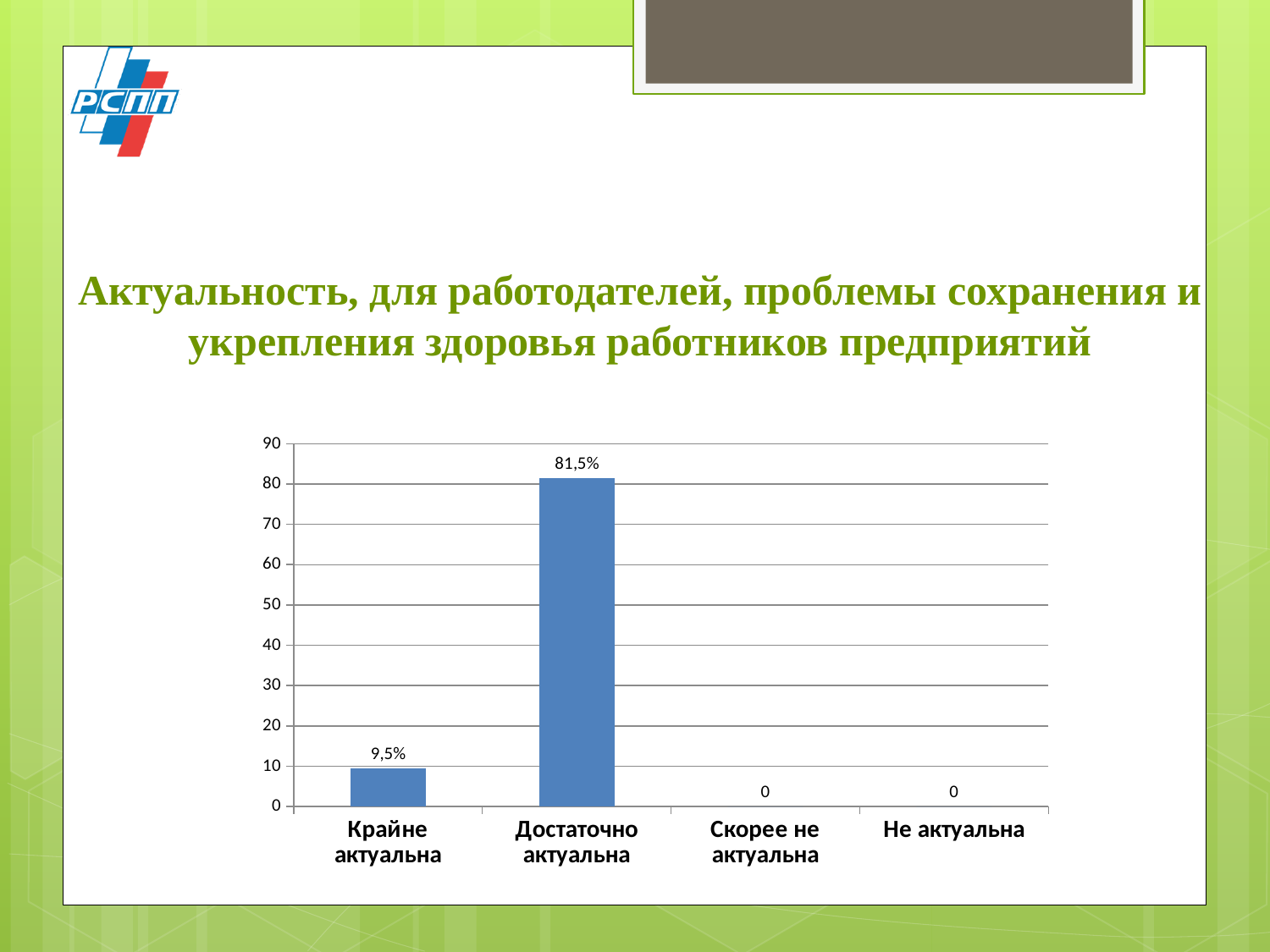
What is the value for "Не актуальна"? 0 What is the value for "Скорее не актуальна"? 0 How many categories are shown on the x axis? 4 What is the highest value shown on the vertical axis? 90 What is the value for "Крайне актуальна"? 9,5% Is the value for "Достаточно актуальна" greater or less than 80? greater Which is larger, the value for "Крайне актуальна" or the value for "Достаточно актуальна"? Достаточно актуальна What is the difference between the values for "Достаточно актуальна" and "Крайне актуальна"? 72% What is the value for "Достаточно актуальна"? 81,5% Which category has the highest value? Достаточно актуальна What kind of chart is shown on the slide? bar chart Is the value for "Крайне актуальна" greater or less than 10? less